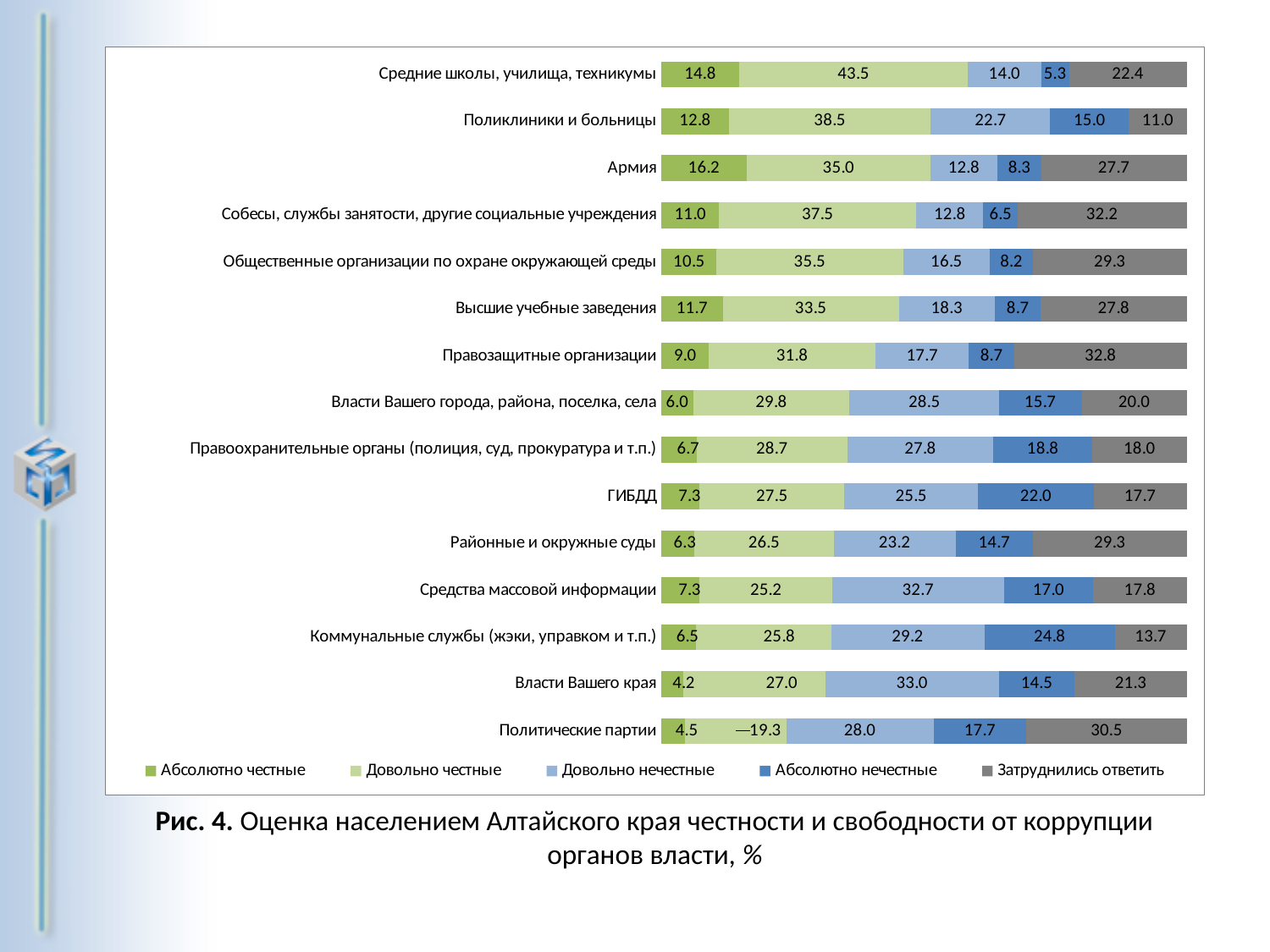
Which category has the highest value for "Абсолютно честные"? Армия What is the value of "Абсолютно честные" for "Армия"? 16.2 What kind of chart is shown on the slide? Stacked bar chart Which category has the lowest value for "Абсолютно честные"? Власти Вашего края How many categories (institutions) are listed on the chart? 15 Which category has the highest value for "Довольно честные"? Средние школы, училища, техникумы What is the difference between the "Абсолютно нечестные" values for "ГИБДД" and "Средства массовой информации"? 5.0 What is the value of "Абсолютно нечестные" for "Коммунальные службы (жэки, управком и т.п.)"? 24.8 Which has a larger "Затруднились ответить" value: "Политические партии" or "Поликлиники и больницы"? Политические партии What is the value of "Затруднились ответить" for "Собесы, службы занятости, другие социальные учреждения"? 32.2 How many series does the legend list? 5 What is the total of the stacked bar for "Средние школы, училища, техникумы"? 100.0